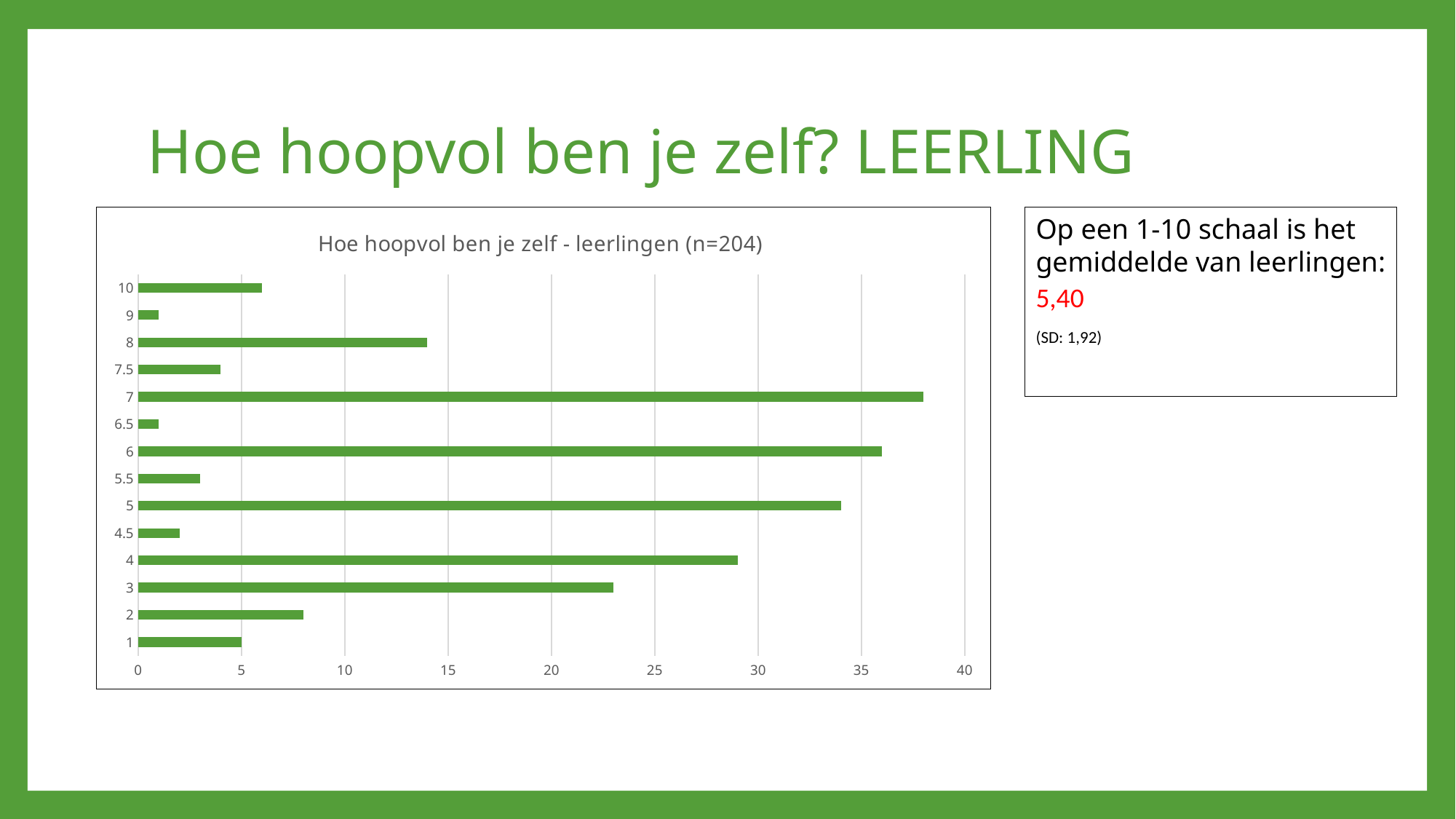
What kind of chart is shown on the slide? bar chart What is the title of the chart? Hoe hoopvol ben je zelf - leerlingen (n=204) Which score category has the longest bar? 7 Which has the larger value, score 3 or score 4? 4 Is the value for score 4 greater or less than 30? less Is the value for score 7 greater or less than 35? greater Is the value for score 2 greater or less than 10? less How many categories (score values) are shown on the vertical axis of the chart? 14 Which has the larger value, score 8 or score 10? 8